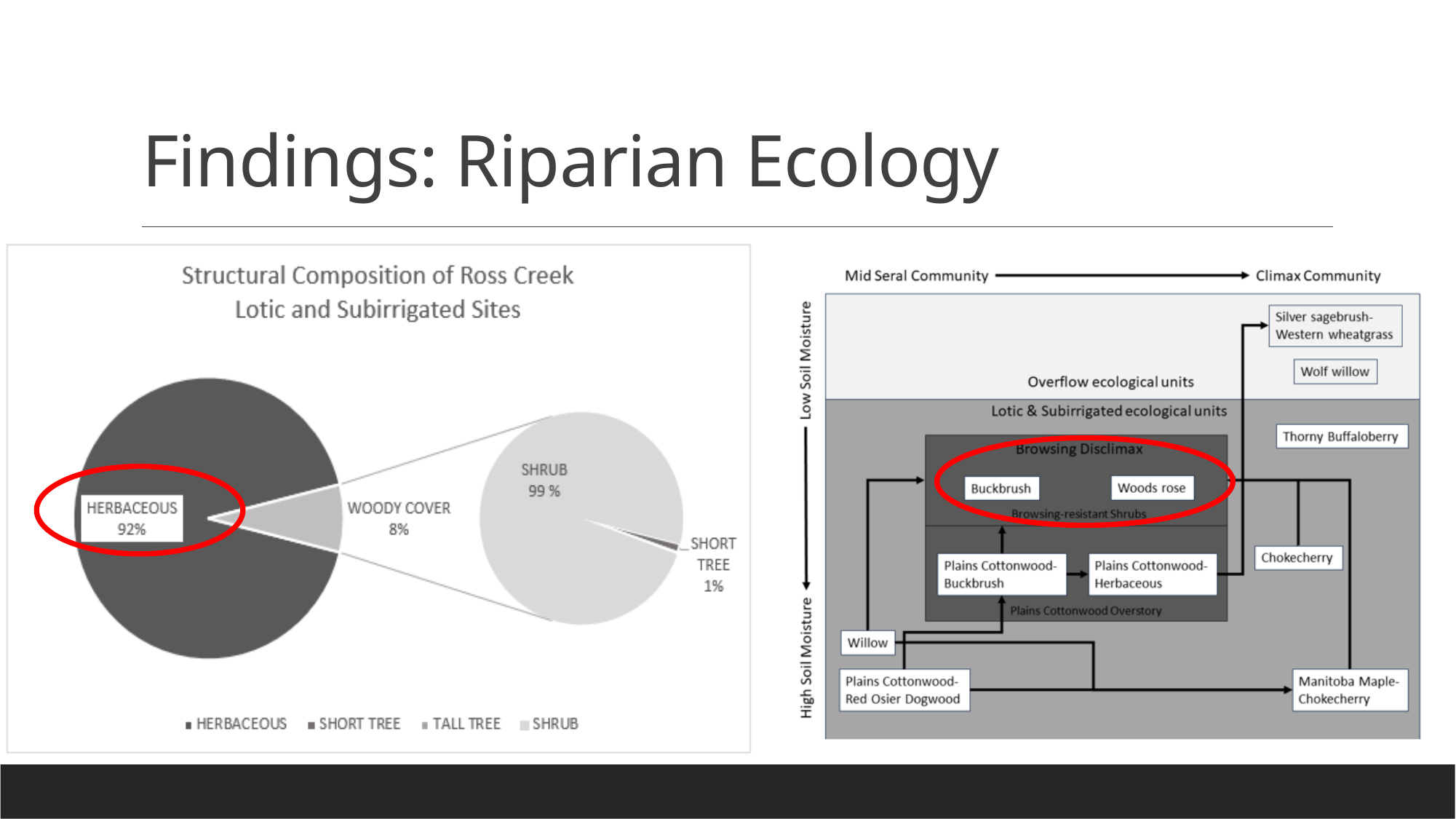
How many entries does the legend of the pie chart list? 4 In the pie chart, what is the difference between the HERBACEOUS share and the WOODY COVER share? 84 percentage points What kind of chart is shown on the left of the slide? Pie chart In the pie chart, what percentage is shown for WOODY COVER? 8% Which slice is the largest in the main pie chart? HERBACEOUS In the pie chart, what percentage is shown for HERBACEOUS? 92% In the breakout pie, what is the difference between the SHRUB share and the SHORT TREE share? 98 percentage points Which slice is the smallest in the breakout pie of the woody cover? SHORT TREE What is the title of the pie chart? Structural Composition of Ross Creek Lotic and Subirrigated Sites In the breakout pie of the woody cover, what percentage is shown for SHRUB? 99 % In the breakout pie of the woody cover, what percentage is shown for SHORT TREE? 1% In the pie chart, which is larger, HERBACEOUS or WOODY COVER? HERBACEOUS